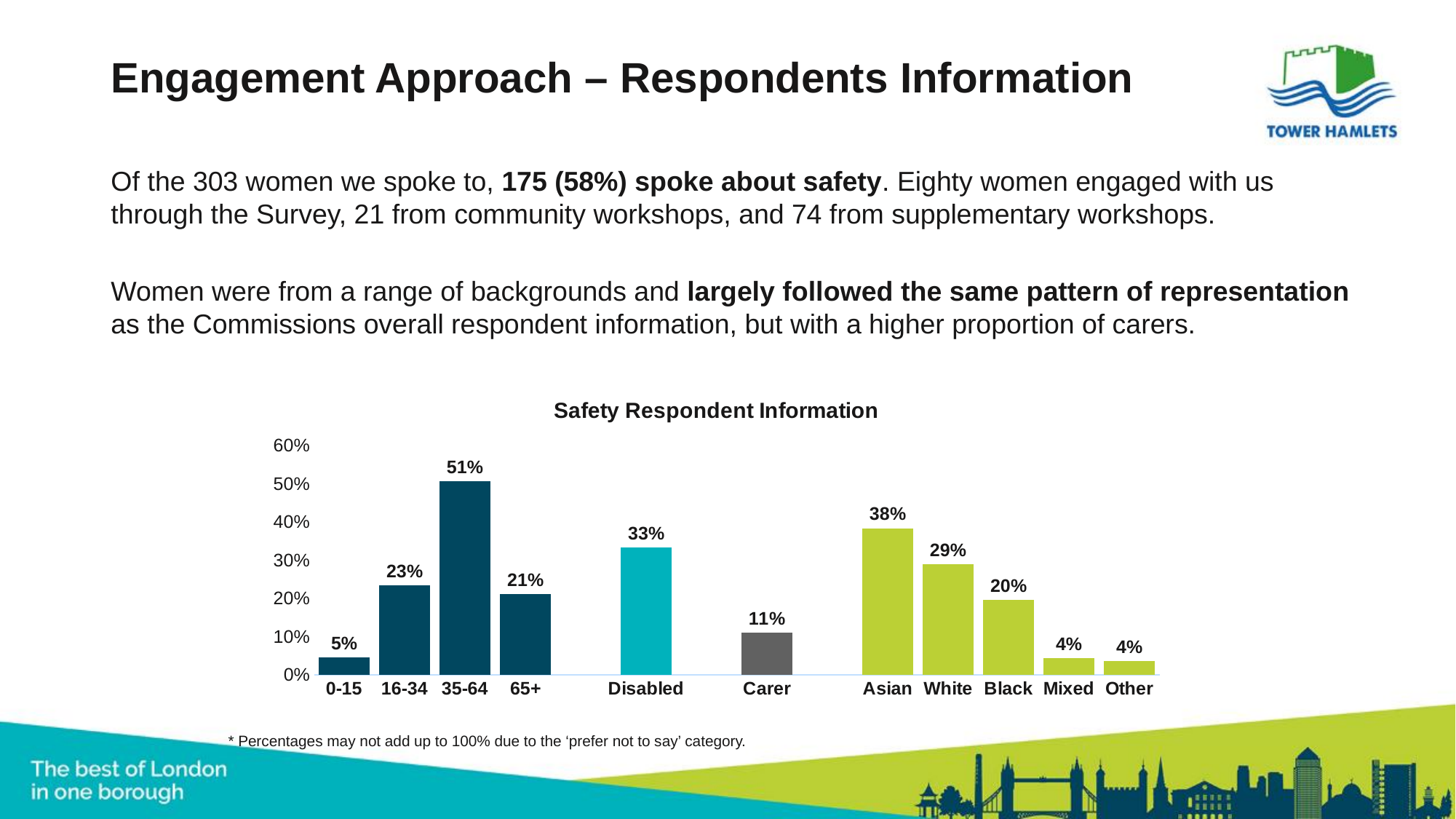
What is the value for the 35-64 age group in the Safety Respondent Information chart? 51% What percentage of safety respondents were Disabled? 33% Which is larger, the value for 16-34 or the value for 65+? 16-34 What kind of chart is shown on the slide? Bar chart What is the value shown for Carer? 11% How many categories are shown on the x axis of the chart? 11 Which category has the highest value in the chart? 35-64 Is the value for Disabled greater or less than 30%? greater What is the difference between the Asian and Black percentages? 18% Which age group has the lowest value? 0-15 What percentage of safety respondents were White? 29% What is the title of the chart? Safety Respondent Information